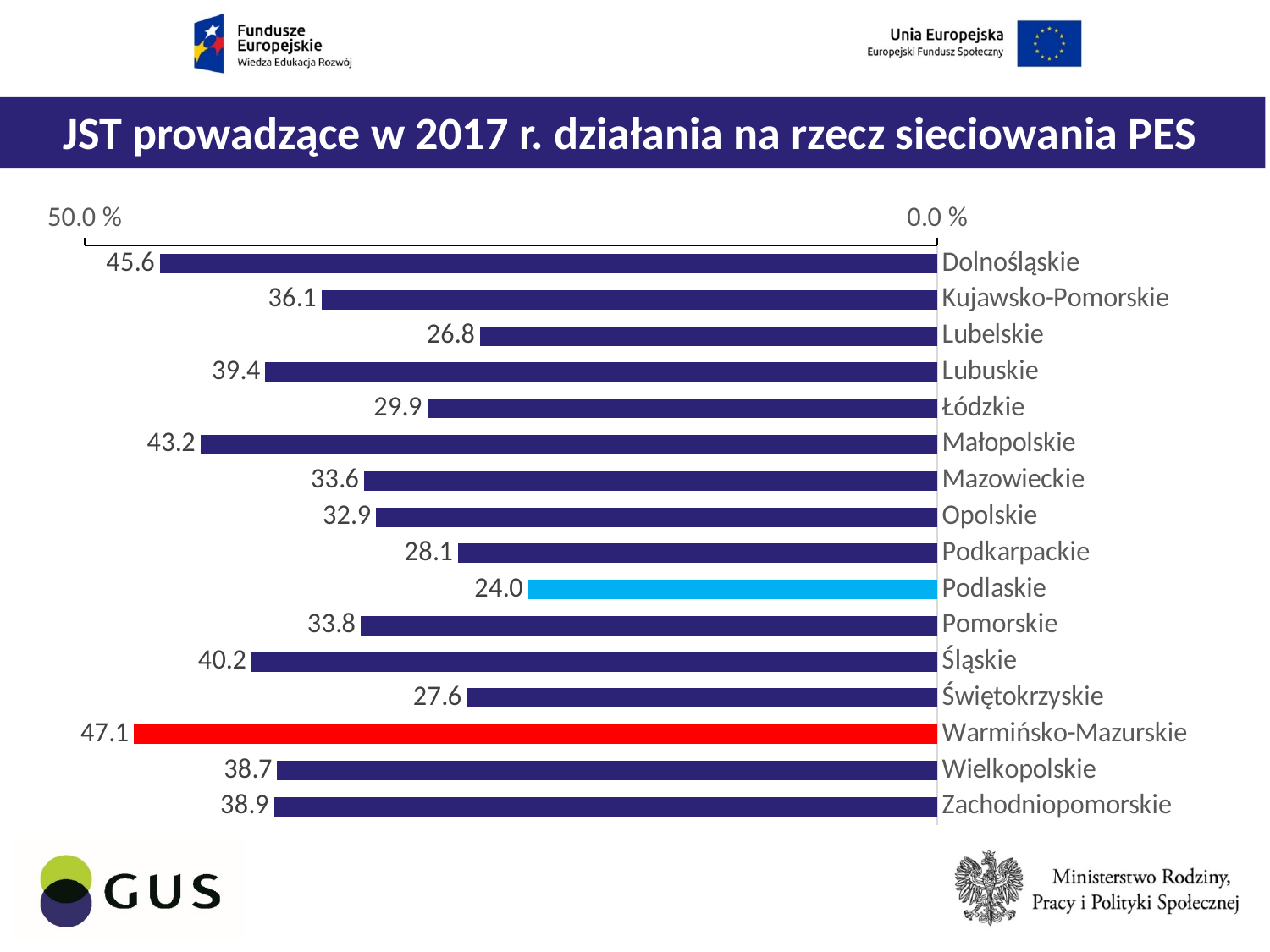
What kind of chart is shown on the slide? Bar chart What is the difference between the values for Warmińsko-Mazurskie and Podlaskie? 23.1 What is the value for Dolnośląskie? 45.6 What is the difference between the values for Dolnośląskie and Małopolskie? 2.4 Which has a larger value, Lubelskie or Łódzkie? Łódzkie What is the value for Zachodniopomorskie? 38.9 How many voivodeships are shown in the chart? 16 Which voivodeship's bar is coloured red? Warmińsko-Mazurskie Which voivodeship has the highest value? Warmińsko-Mazurskie Which has a larger value, Śląskie or Lubuskie? Śląskie What is the value for Podkarpackie? 28.1 Which voivodeship has the lowest value? Podlaskie